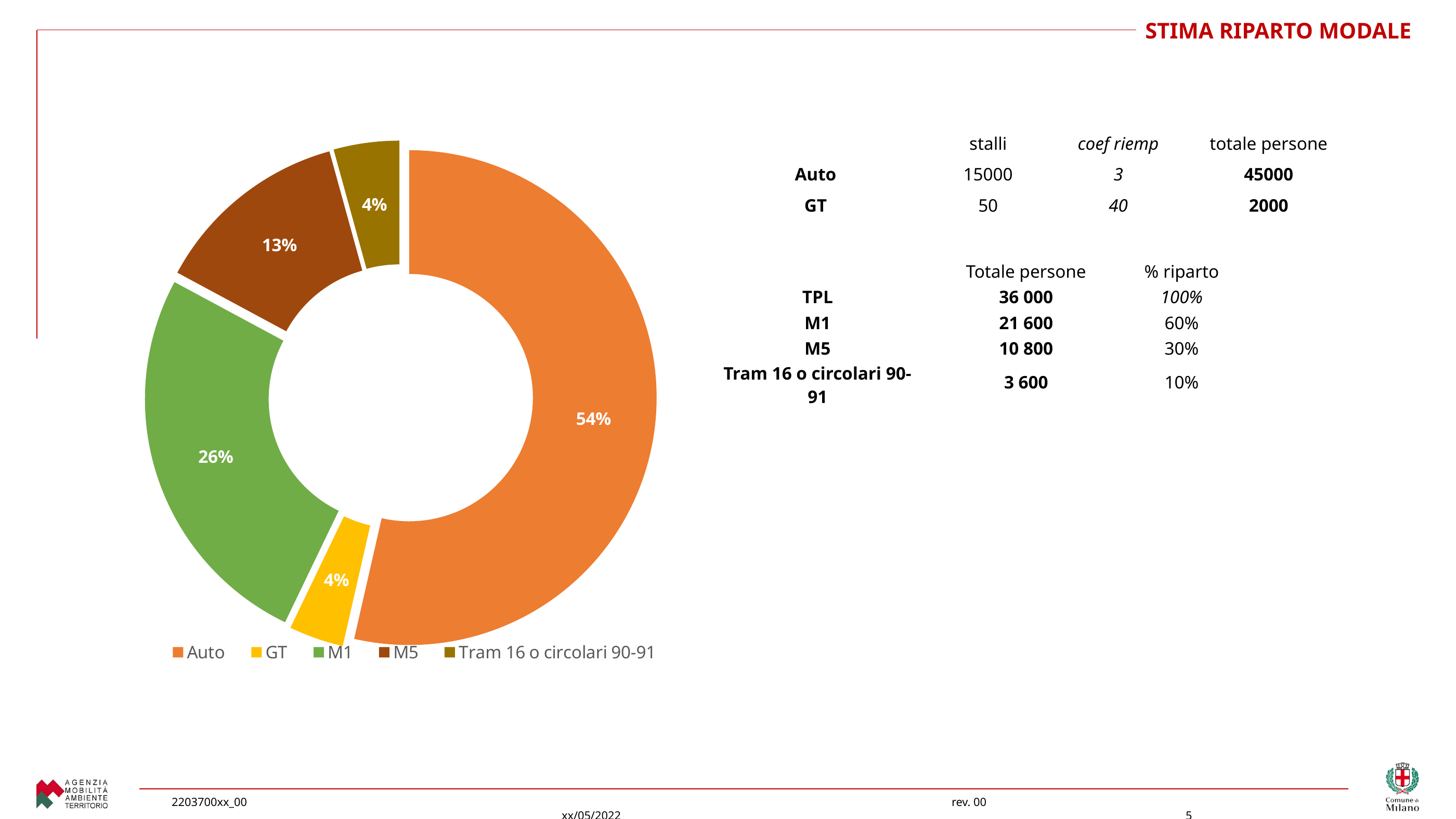
Which category has the largest slice in the pie chart? Auto What is the difference in percentage points between Auto and M1 in the pie chart? 28 What is the value shown for M5 in the pie chart? 13% Which is larger in the pie chart, M5 or GT? M5 What is the value shown for M1 in the pie chart? 26% Which is larger in the pie chart, Auto or M1? Auto What colour is the Auto slice in the pie chart? orange What kind of chart is shown on the slide? doughnut chart What share of the pie chart does Auto represent? 54% What is the value shown for Tram 16 o circolari 90-91 in the pie chart? 4% What is the value shown for GT in the pie chart? 4% How many categories are shown in the pie chart? 5